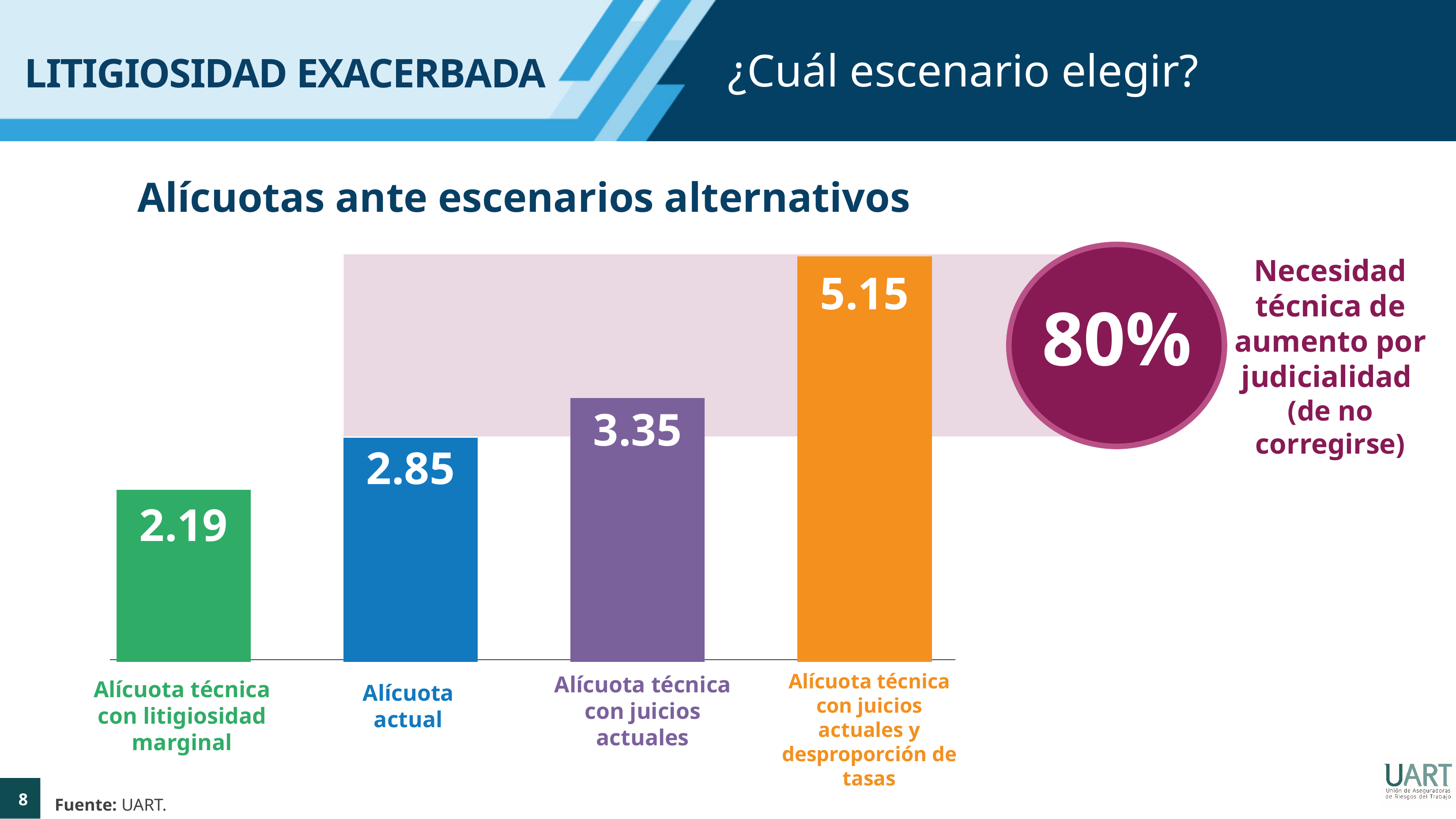
Which category has the highest value? Alícuota técnica con juicios actuales y desproporción de tasas What is the value for 'Alícuota técnica con litigiosidad marginal'? 2.19 What is the difference between 'Alícuota técnica con juicios actuales y desproporción de tasas' and 'Alícuota actual'? 2.30 What is the title of the chart? Alícuotas ante escenarios alternativos How many categories are shown in the chart? 4 What kind of chart is shown on the slide? Bar chart Which is larger: 'Alícuota actual' or 'Alícuota técnica con litigiosidad marginal'? Alícuota actual What is the difference between 'Alícuota técnica con juicios actuales' and 'Alícuota actual'? 0.50 What is the value for 'Alícuota técnica con juicios actuales'? 3.35 Which category has the lowest value? Alícuota técnica con litigiosidad marginal What is the value for 'Alícuota actual'? 2.85 What is the value for 'Alícuota técnica con juicios actuales y desproporción de tasas'? 5.15